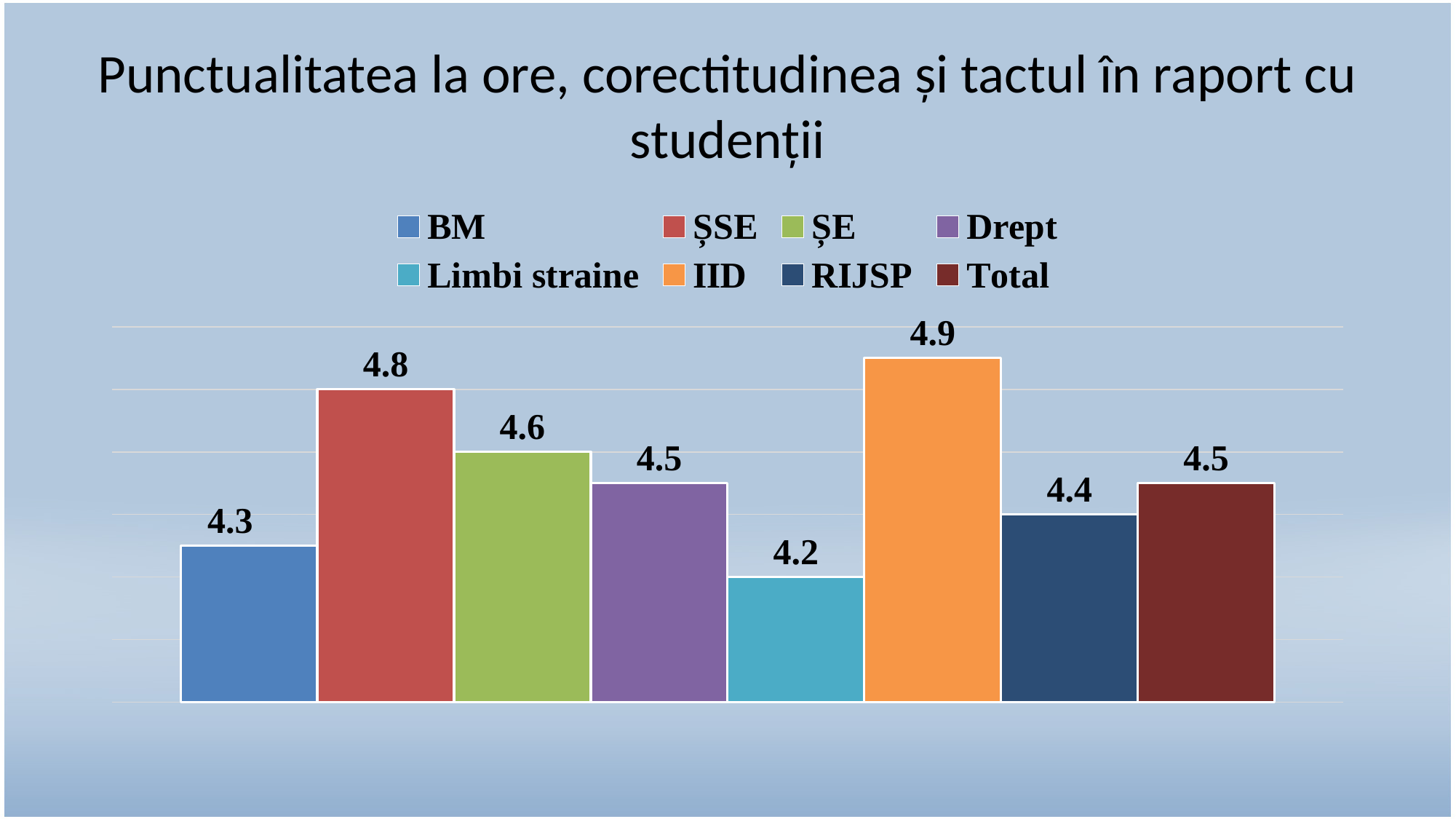
Which series has the lowest value? Limbi straine Which is larger, the value for ȘE or the value for Drept? ȘE What is the value for Limbi straine? 4.2 How many series does the legend list? 8 What is the title of the chart? Punctualitatea la ore, corectitudinea și tactul în raport cu studenții Which series has the highest value? IID What is the difference between the values for ȘSE and BM? 0.5 What kind of chart is shown on the slide? Bar chart What is the value for IID? 4.9 What colour is the bar for Total? Dark red What is the value for RIJSP? 4.4 What is the value for BM? 4.3